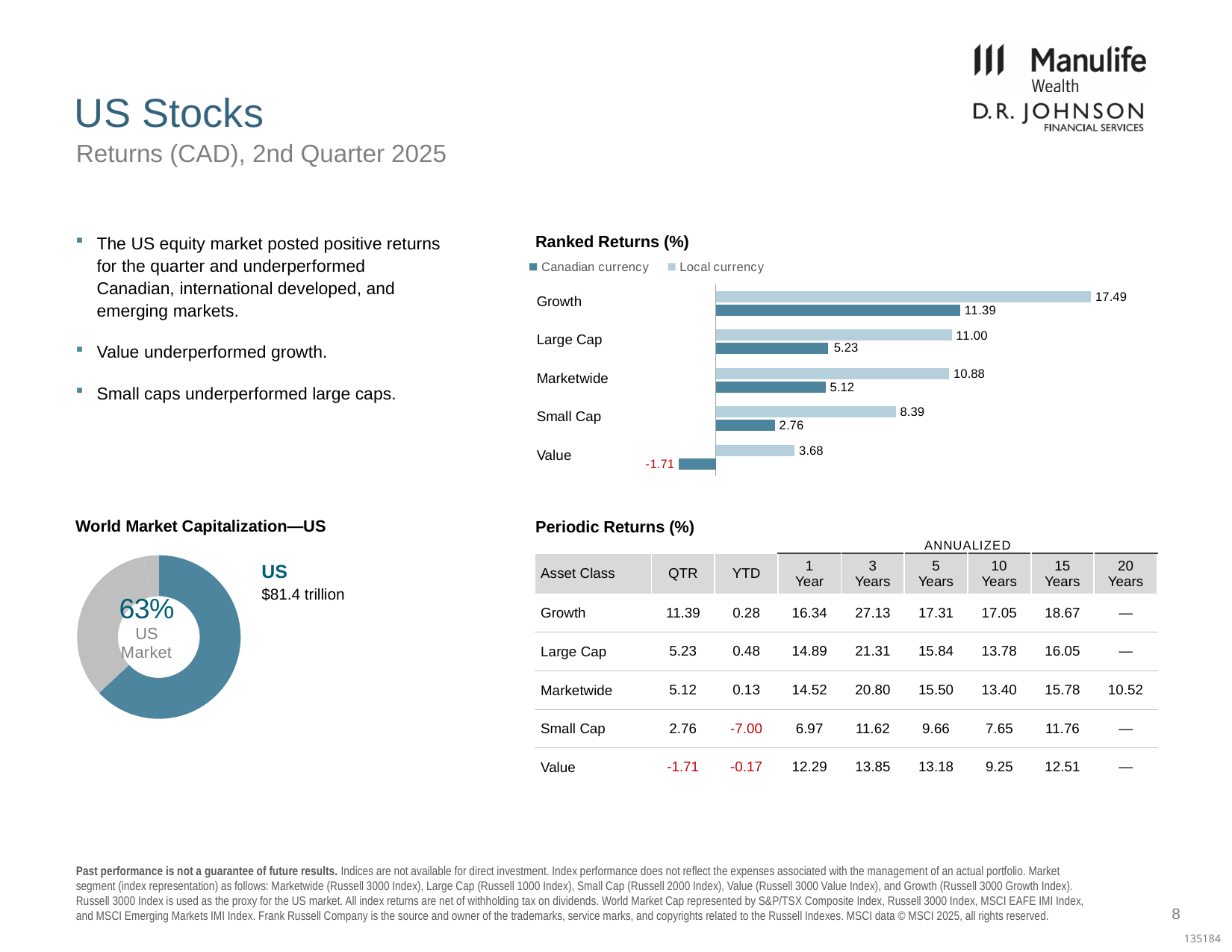
What kind of chart is the World Market Capitalization—US chart? Donut (pie) chart In the Ranked Returns (%) chart, which category has the highest Local currency return? Growth In the Ranked Returns (%) chart, what is the Canadian currency return for Value? -1.71 In the Ranked Returns (%) chart, what is the difference between the Local currency and Canadian currency returns for Large Cap? 5.77 In the Ranked Returns (%) chart, what is the Local currency return for Small Cap? 8.39 In the Ranked Returns (%) chart, which category has the lowest Canadian currency return? Value How many categories are shown in the Ranked Returns (%) chart? 5 In the Ranked Returns (%) chart, which is larger: the Canadian currency return for Marketwide or for Small Cap? Marketwide In the World Market Capitalization—US chart, what share of the world market does the US represent? 63% In the Ranked Returns (%) chart, what is the Canadian currency return for Growth? 11.39 What kind of chart is the Ranked Returns (%) chart? Bar chart How many series does the legend of the Ranked Returns (%) chart list? 2